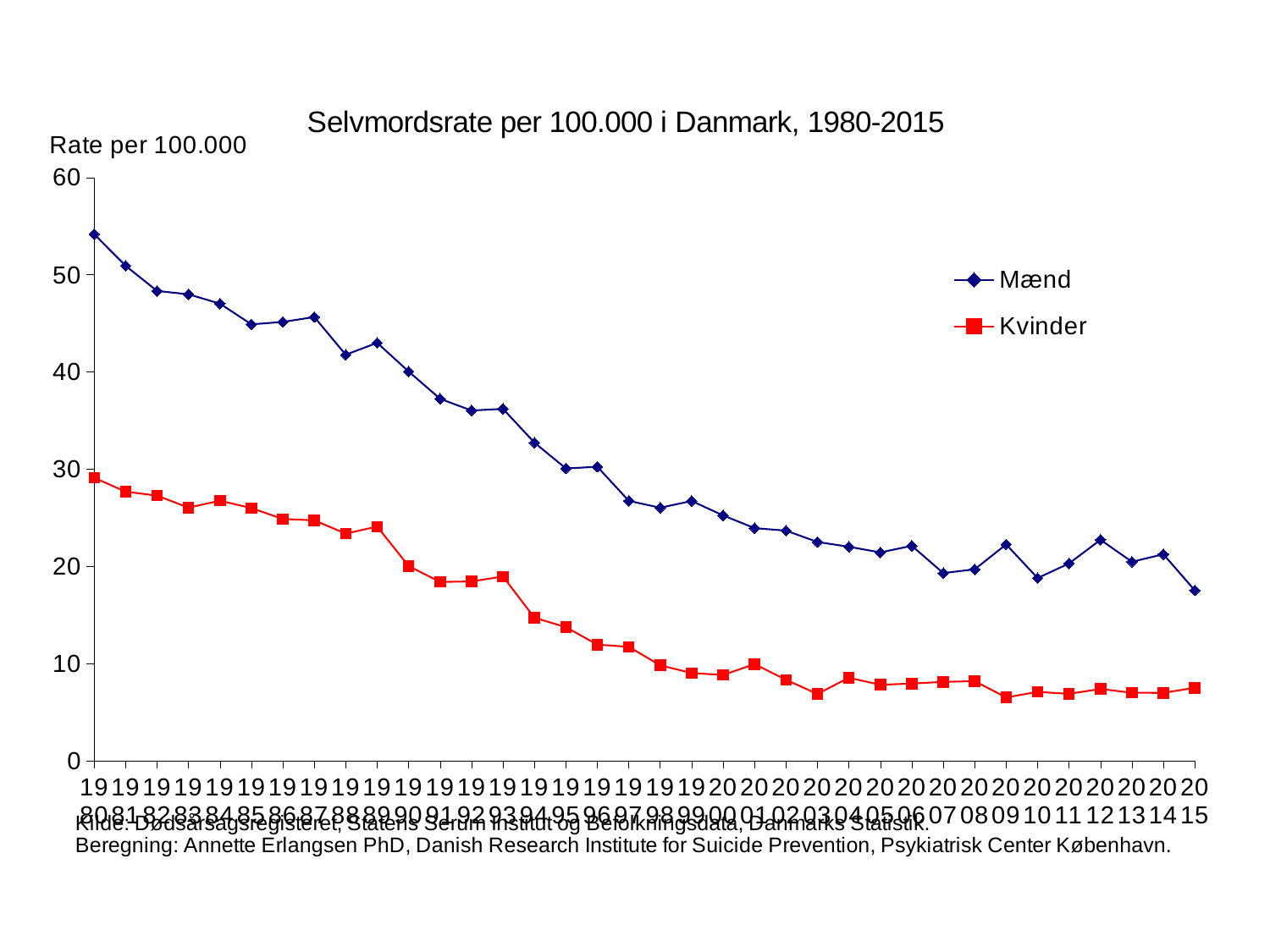
What kind of chart is shown on the slide? line chart Is the value for Kvinder in 2015 greater or less than 10? less Is the value for Mænd in 2015 greater or less than 20? less How many series does the legend list? 2 Which series has the larger value in 1980, Mænd or Kvinder? Mænd In which year is the value for Mænd highest? 1980 Which two series are listed in the legend? Mænd and Kvinder Is the value for Mænd in 1980 greater or less than 50? greater How many years (data points) are plotted along the x axis? 36 What is the title of the chart? Selvmordsrate per 100.000 i Danmark, 1980-2015 Do the values for Kvinder generally rise or fall from 1980 to 2015? fall Do the values for Mænd generally rise or fall from 1980 to 2015? fall